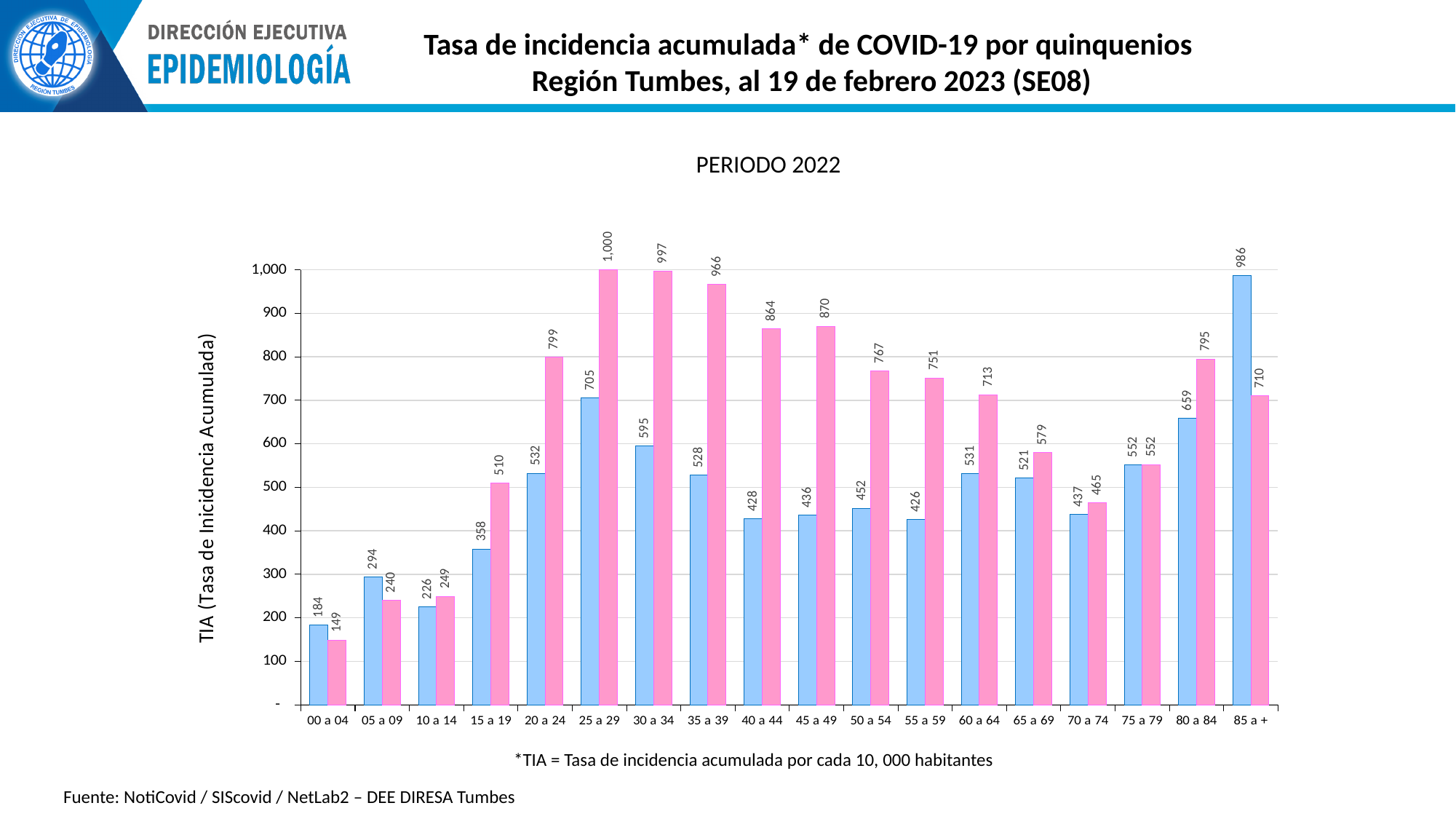
Is the value of the pink bar for the age group 30 a 34 greater or less than 900? greater What type of chart is shown on the slide? bar chart How many age groups (quinquenios) are shown on the x axis? 18 What is the title shown above the chart? PERIODO 2022 For the age group 85 a +, which bar is larger, the blue or the pink? blue Which age group has the highest blue bar? 85 a + Which age group has the lowest pink bar? 00 a 04 What is the difference between the pink bar and the blue bar for the age group 20 a 24? 267 What is the value of the pink bar for the age group 40 a 44? 864 What is the value of the pink bar for the age group 25 a 29? 1,000 What is the value of the blue bar for the age group 25 a 29? 705 What is the value of the blue bar for the age group 75 a 79? 552